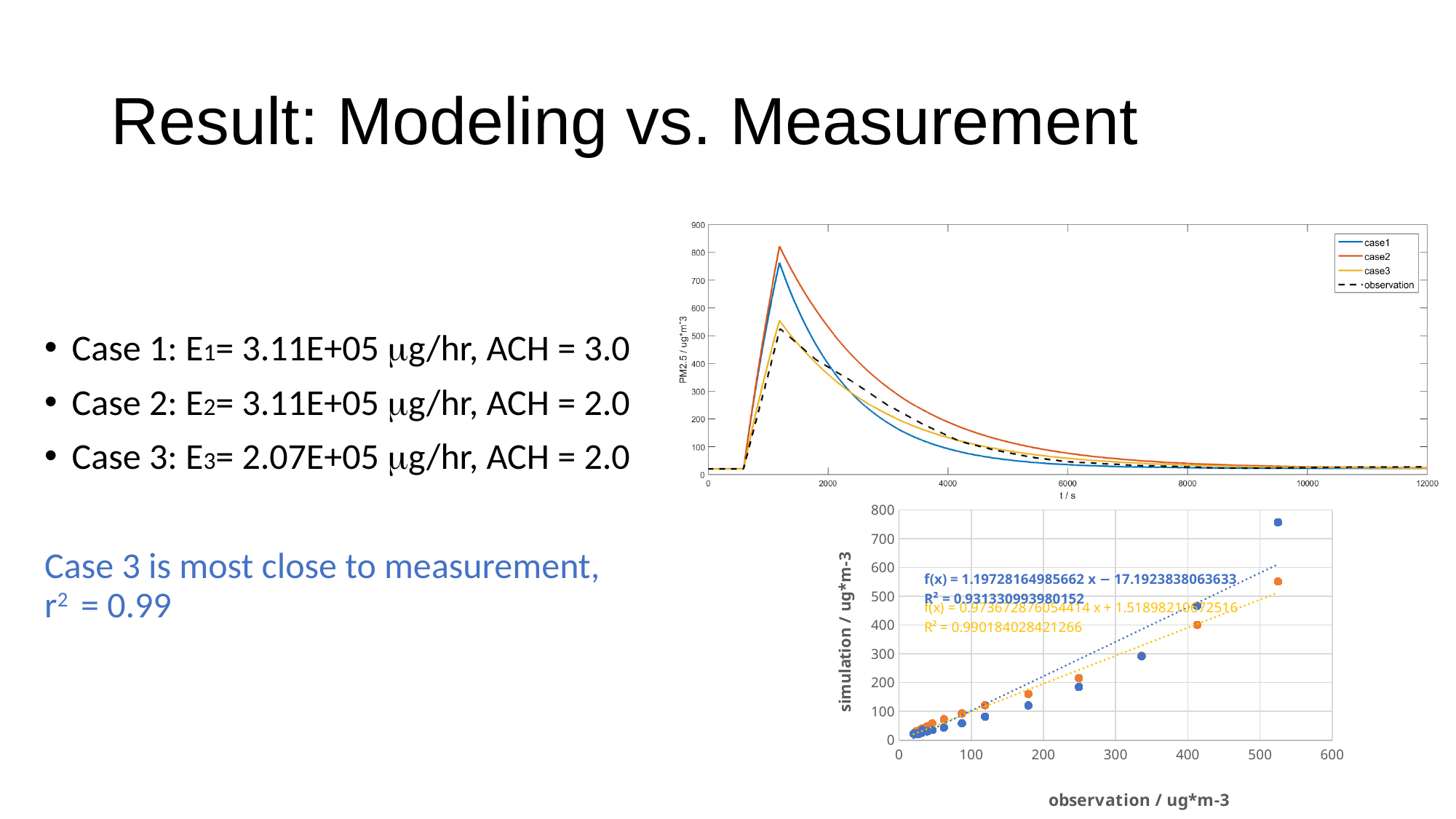
In the bottom chart, is the highest blue point greater or less than 700 on the simulation axis? greater In the top chart, is the peak value of case2 greater or less than 800? greater What kind of chart is the bottom chart plotting simulation against observation? scatter chart In the top chart, which peaks higher, case1 or case3? case1 In the top chart, do the case2 values rise or fall along the x axis after about t = 2000 s? fall In the top chart (PM2.5 vs t / s), how many series does the legend list? 4 In the bottom chart, what is the R² value printed for the blue trendline? 0.931330993980152 In the top chart, is the peak value of case3 greater or less than 500? greater What kind of chart is the top chart showing PM2.5 against t / s? line chart In the top chart, which series reaches the highest peak value? case2 In the bottom chart, what is the R² value printed for the orange (yellow) trendline? 0.990184028421266